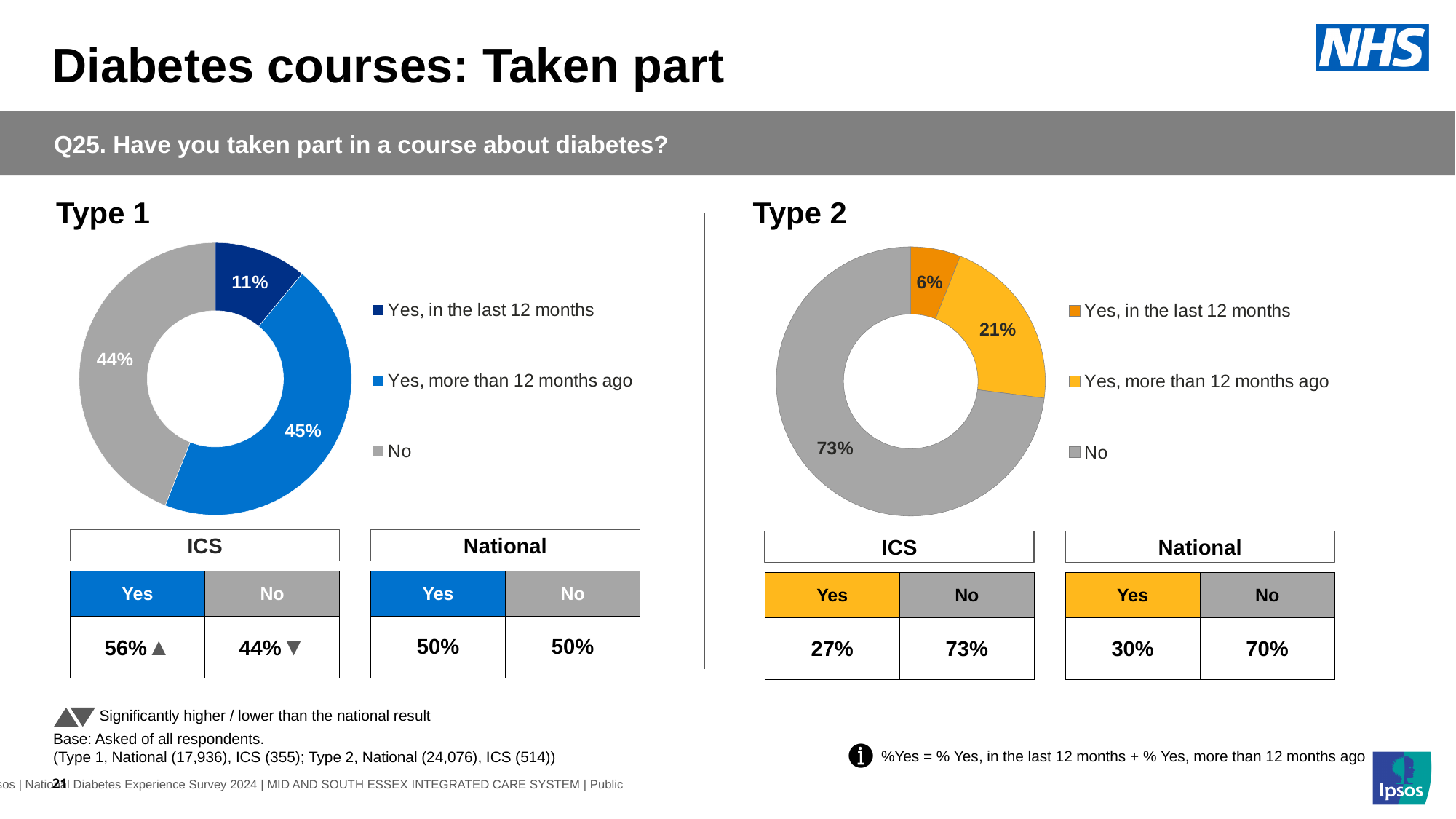
In the Type 2 chart, which category has the largest share? No In the Type 2 chart, what is the difference between the 'No' share and the 'Yes, more than 12 months ago' share? 52 percentage points In the Type 2 chart, what colour represents 'Yes, in the last 12 months'? Dark orange What kind of chart is used for Type 1? Doughnut chart How many categories does the Type 2 chart's legend list? 3 In the Type 2 chart, what percentage of respondents said 'Yes, more than 12 months ago'? 21% In the Type 1 chart, what is the combined share of the two 'Yes' categories? 56% In the Type 1 chart, which category has the smallest share? Yes, in the last 12 months In the Type 2 chart, what percentage of respondents said 'No'? 73% In the Type 1 chart, which is larger: 'Yes, more than 12 months ago' or 'No'? Yes, more than 12 months ago In the Type 1 chart, what percentage of respondents said 'Yes, in the last 12 months'? 11% In the Type 1 chart, what percentage of respondents said 'Yes, more than 12 months ago'? 45%